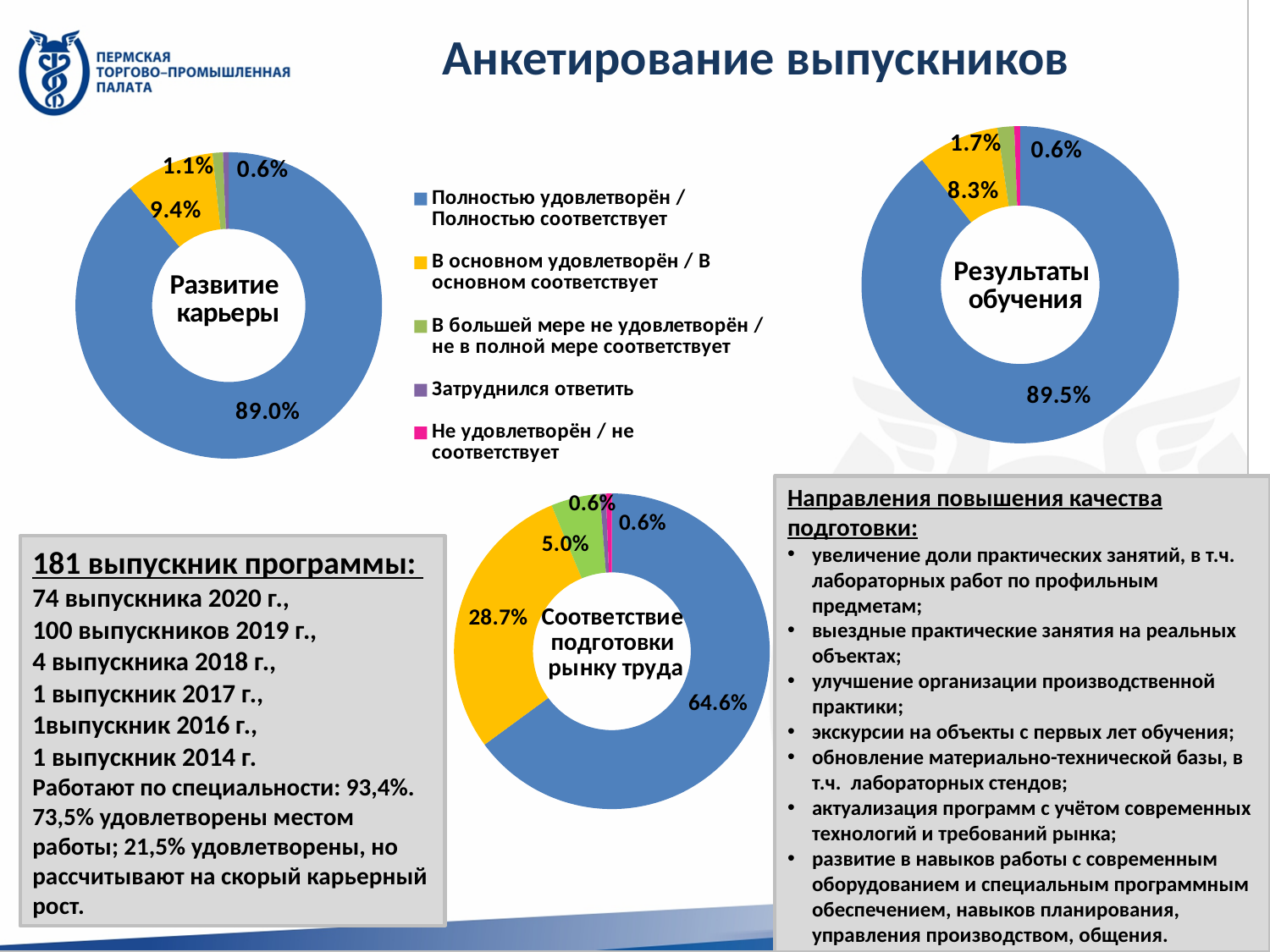
In the "Результаты обучения" chart, what share is "В основном удовлетворён / В основном соответствует"? 8.3% In the "Развитие карьеры" chart, what share is "В основном удовлетворён / В основном соответствует"? 9.4% In the "Соответствие подготовки рынку труда" chart, what share is "Полностью удовлетворён / Полностью соответствует"? 64.6% What kind of chart is used for "Развитие карьеры"? pie chart (donut) In the "Развитие карьеры" chart, what is the difference between the "Полностью удовлетворён" share and the "В основном удовлетворён" share? 79.6 percentage points Which chart has the larger "Полностью удовлетворён" share: "Развитие карьеры" or "Результаты обучения"? Результаты обучения How many entries does the shared legend list? 5 In the "Соответствие подготовки рынку труда" chart, which category has the largest share? Полностью удовлетворён / Полностью соответствует In the "Соответствие подготовки рынку труда" chart, what share is "В большей мере не удовлетворён / не в полной мере соответствует"? 5.0% In the "Развитие карьеры" chart, what share is "Полностью удовлетворён / Полностью соответствует"? 89.0% In the "Результаты обучения" chart, what share is "В большей мере не удовлетворён / не в полной мере соответствует"? 1.7% In the "Соответствие подготовки рынку труда" chart, what is the difference between the 64.6% slice and the 28.7% slice? 35.9 percentage points